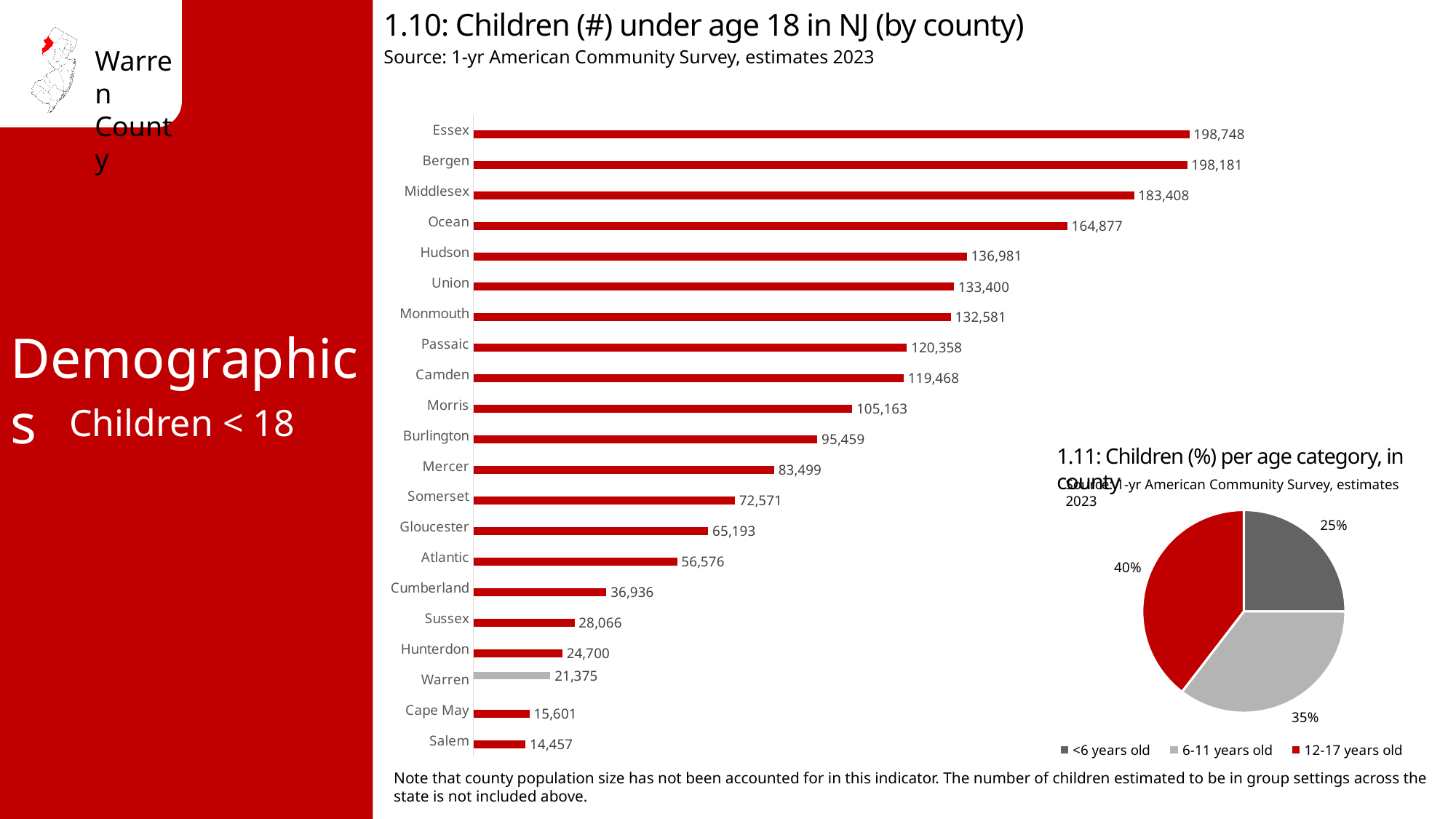
How many counties are shown in the chart '1.10: Children (#) under age 18 in NJ (by county)'? 21 In the chart '1.10: Children (#) under age 18 in NJ (by county)', which county has the highest value? Essex What kind of chart is '1.10: Children (#) under age 18 in NJ (by county)'? Bar chart In the chart '1.10: Children (#) under age 18 in NJ (by county)', what is the value for Warren? 21,375 In the chart '1.10: Children (#) under age 18 in NJ (by county)', which has a larger value, Ocean or Middlesex? Middlesex In the chart '1.10: Children (#) under age 18 in NJ (by county)', which county has the lowest value? Salem In the pie chart '1.11: Children (%) per age category, in county', which age category has the largest share? 12-17 years old In the pie chart '1.11: Children (%) per age category, in county', what share is 6-11 years old? 35% In the chart '1.10: Children (#) under age 18 in NJ (by county)', what is the difference between the values for Essex and Bergen? 567 How many categories does the legend of the pie chart '1.11: Children (%) per age category, in county' list? 3 In the chart '1.10: Children (#) under age 18 in NJ (by county)', what is the value for Hudson? 136,981 In the chart '1.10: Children (#) under age 18 in NJ (by county)', what is the difference between the values for Warren and Hunterdon? 3,325